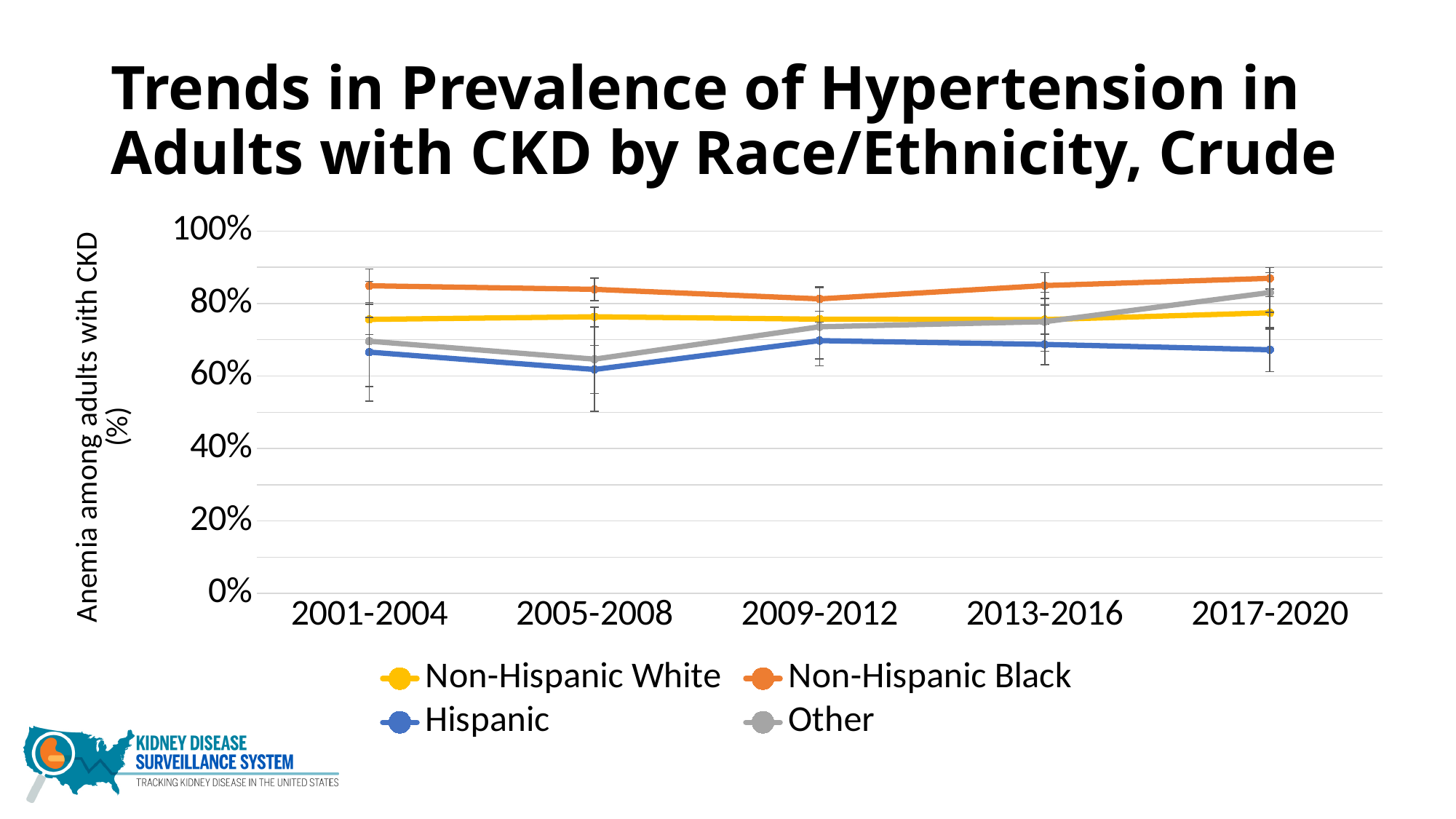
In 2013-2016, which is larger: the value for Non-Hispanic White or the value for Hispanic? Non-Hispanic White Does the value for Other rise or fall from 2009-2012 to 2017-2020? rise Which race/ethnicity group has the lowest value in 2017-2020? Hispanic How many time periods are shown on the x axis? 5 Is the value for Hispanic in 2005-2008 greater or less than 80%? less Which race/ethnicity group has the lowest value in 2005-2008? Hispanic Is the value for Non-Hispanic Black in 2017-2020 greater or less than 80%? greater What kind of chart is shown on the slide? line chart Which race/ethnicity group has the highest value in 2001-2004? Non-Hispanic Black Is the value for Other in 2001-2004 greater or less than 80%? less How many series does the legend list? 4 What colour is the Hispanic series line? blue